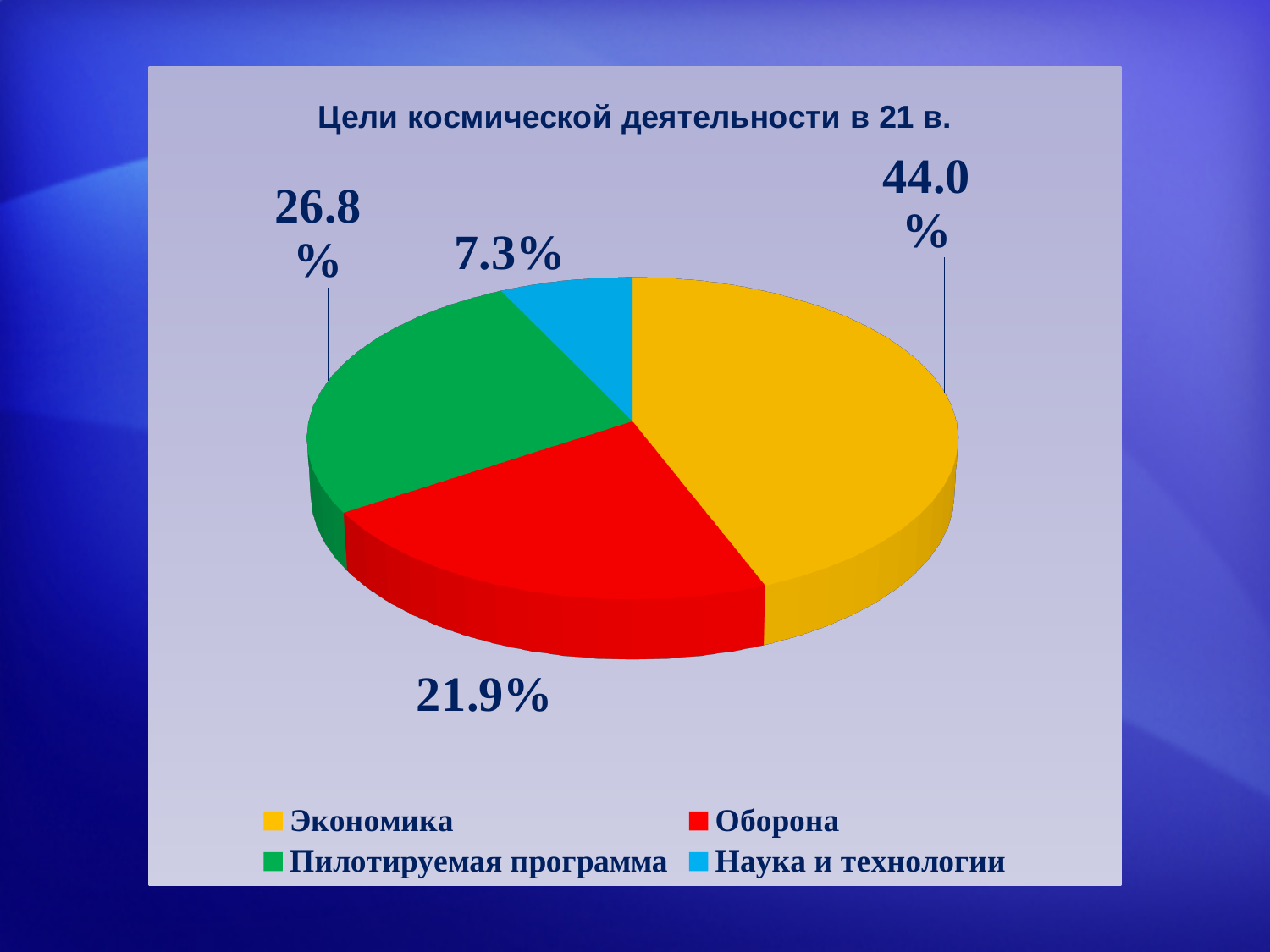
What is the title of the chart? Цели космической деятельности в 21 в. Which is larger, the share for Оборона or the share for Пилотируемая программа? Пилотируемая программа Which category has the smallest slice of the pie? Наука и технологии Which category has the largest slice of the pie? Экономика How many categories does the pie chart show? 4 What is the difference between the shares for Экономика and Оборона? 22.1% What share of the pie does Наука и технологии have? 7.3% What share of the pie does Экономика have? 44.0% What share of the pie does Оборона have? 21.9% What share of the pie does Пилотируемая программа have? 26.8% What colour is the slice for Оборона? red What kind of chart is shown on the slide? pie chart